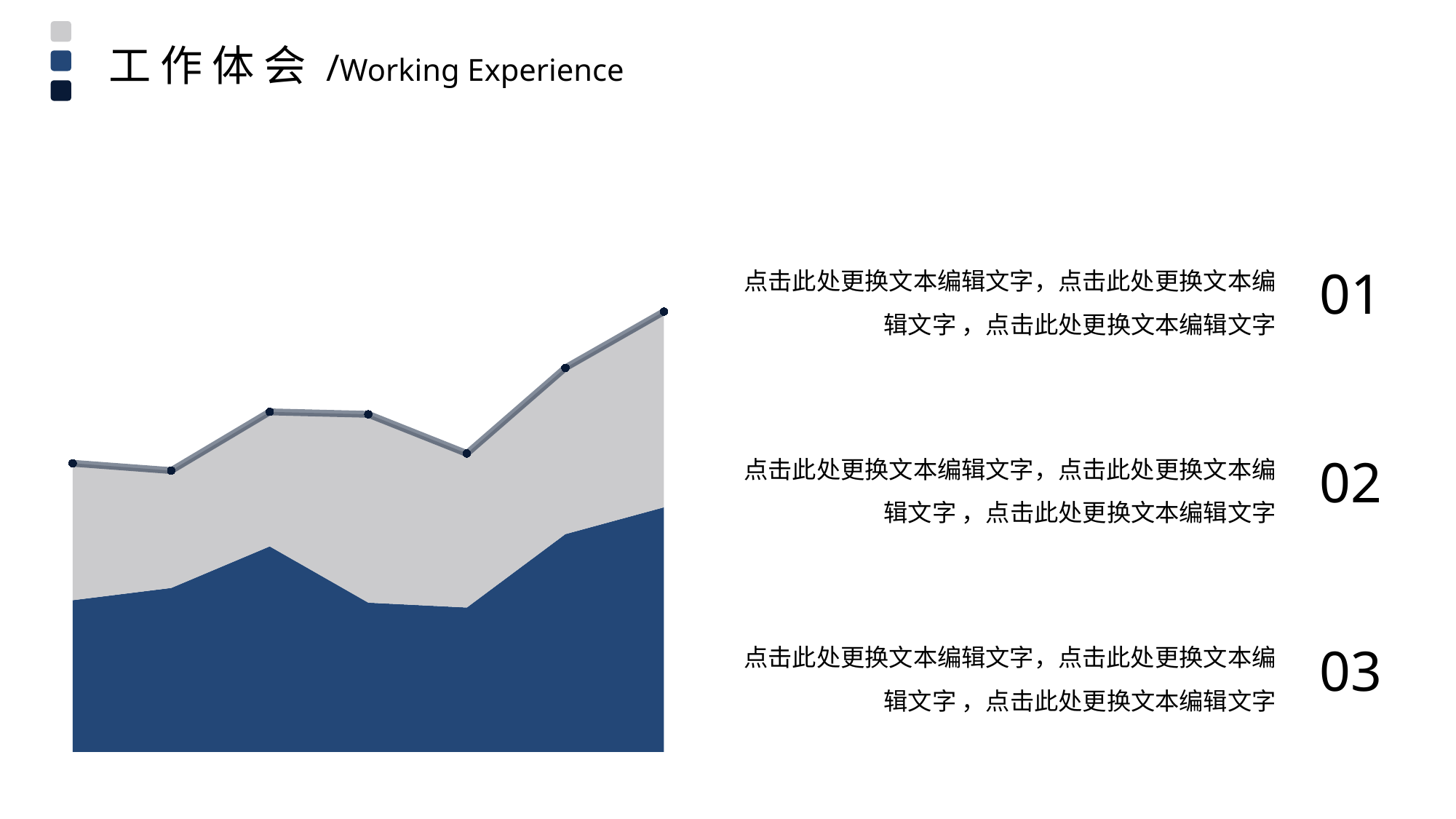
Does the upper line of the chart end higher or lower than it starts? higher How many data points are marked on the upper line of the chart? 7 What kind of chart is shown on the slide? area chart Which marked point on the upper line is the highest? the rightmost (last) point What colour is the lower shaded area of the chart? dark blue How many shaded areas (series) are stacked in the chart? 2